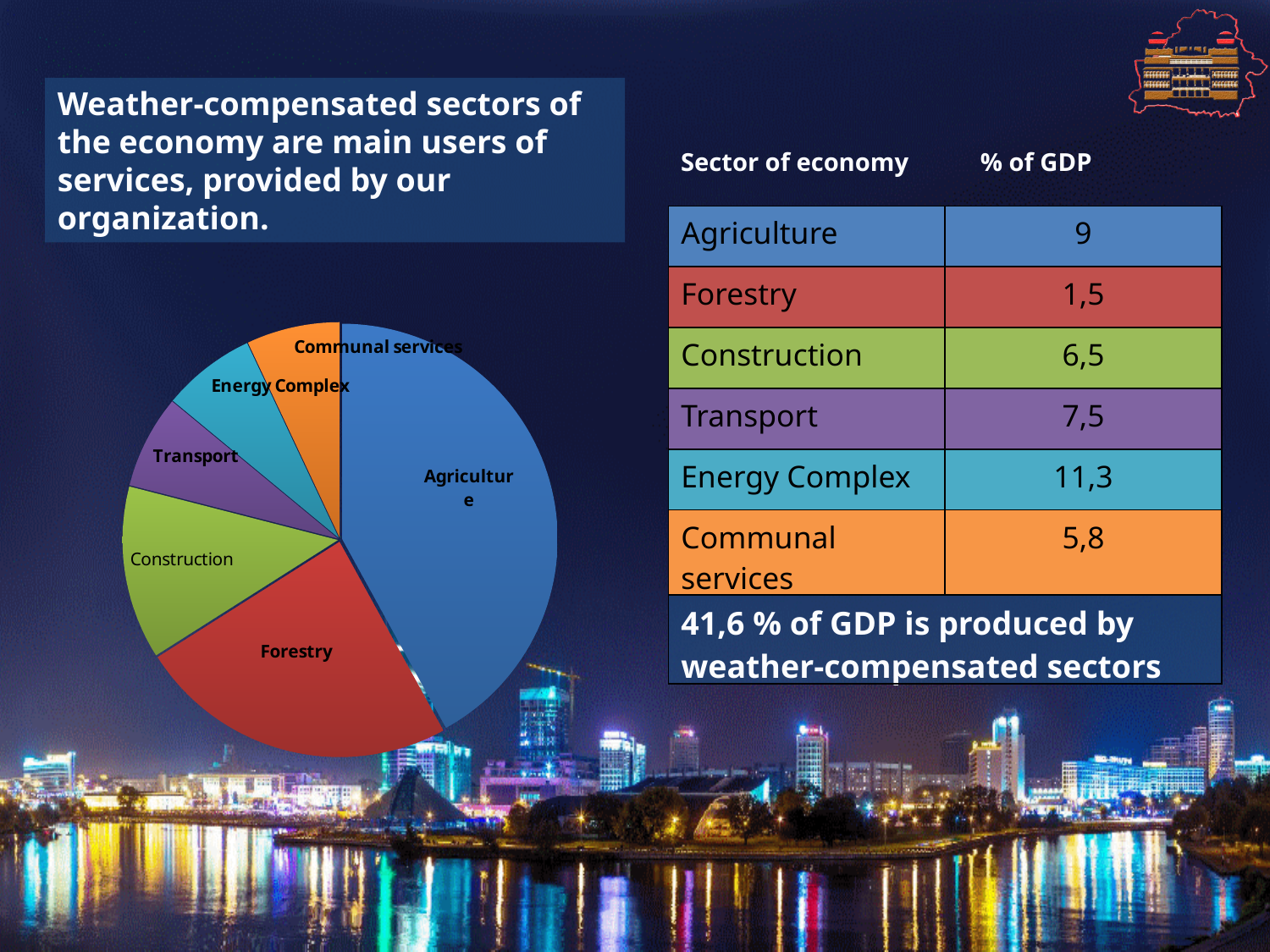
What kind of chart is shown on the left of the slide? pie chart In the pie chart, which slice is larger, Agriculture or Forestry? Agriculture In the table next to the pie chart, what % of GDP is listed for Energy Complex? 11,3 In the table next to the pie chart, what % of GDP is listed for Forestry? 1,5 How many slices does the pie chart have? 6 In the pie chart, which slice is larger, Forestry or Construction? Forestry In the pie chart, which slice is larger, Construction or Transport? Construction In the table next to the pie chart, what % of GDP is listed for Communal services? 5,8 What colour is the Forestry slice in the pie chart? red What colour is the Agriculture slice in the pie chart? blue Which sector has the largest slice in the pie chart? Agriculture